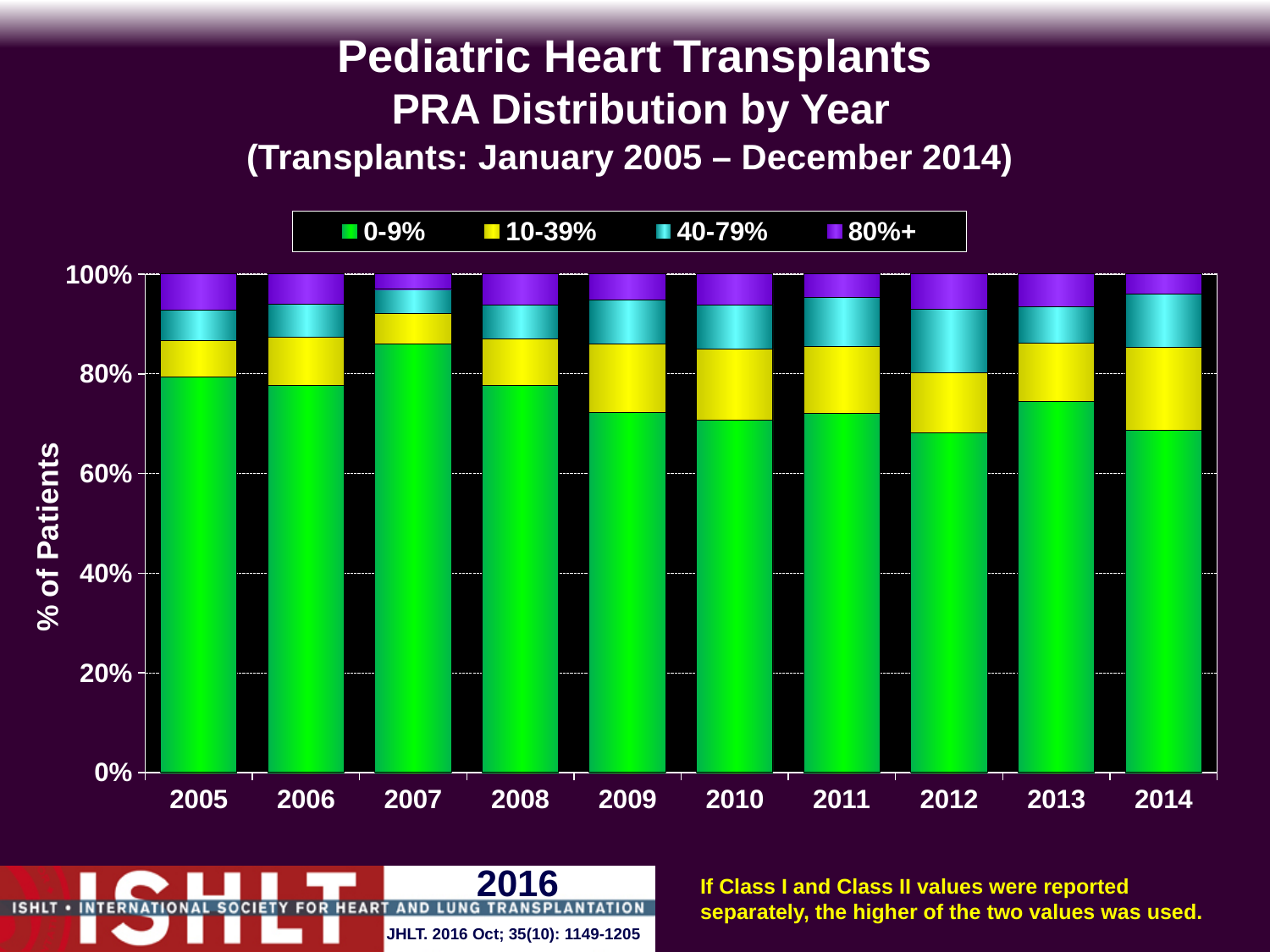
How many years (categories) are shown on the x axis? 10 How many series does the legend list? 4 Which year has a larger 0-9% PRA segment, 2009 or 2007? 2007 What is the label of the y axis? % of Patients Which colour represents the 80%+ PRA category in the legend? Purple What type of chart is shown on the slide? Stacked bar chart Is the 0-9% share of patients in 2007 greater or less than 80%? greater What does each stacked bar total? 100% Which year has a larger 0-9% PRA segment, 2007 or 2012? 2007 Is the 0-9% share of patients in 2010 greater or less than 80%? less Which year has the largest 0-9% PRA segment? 2007 Is the 0-9% share of patients in 2012 greater or less than 80%? less